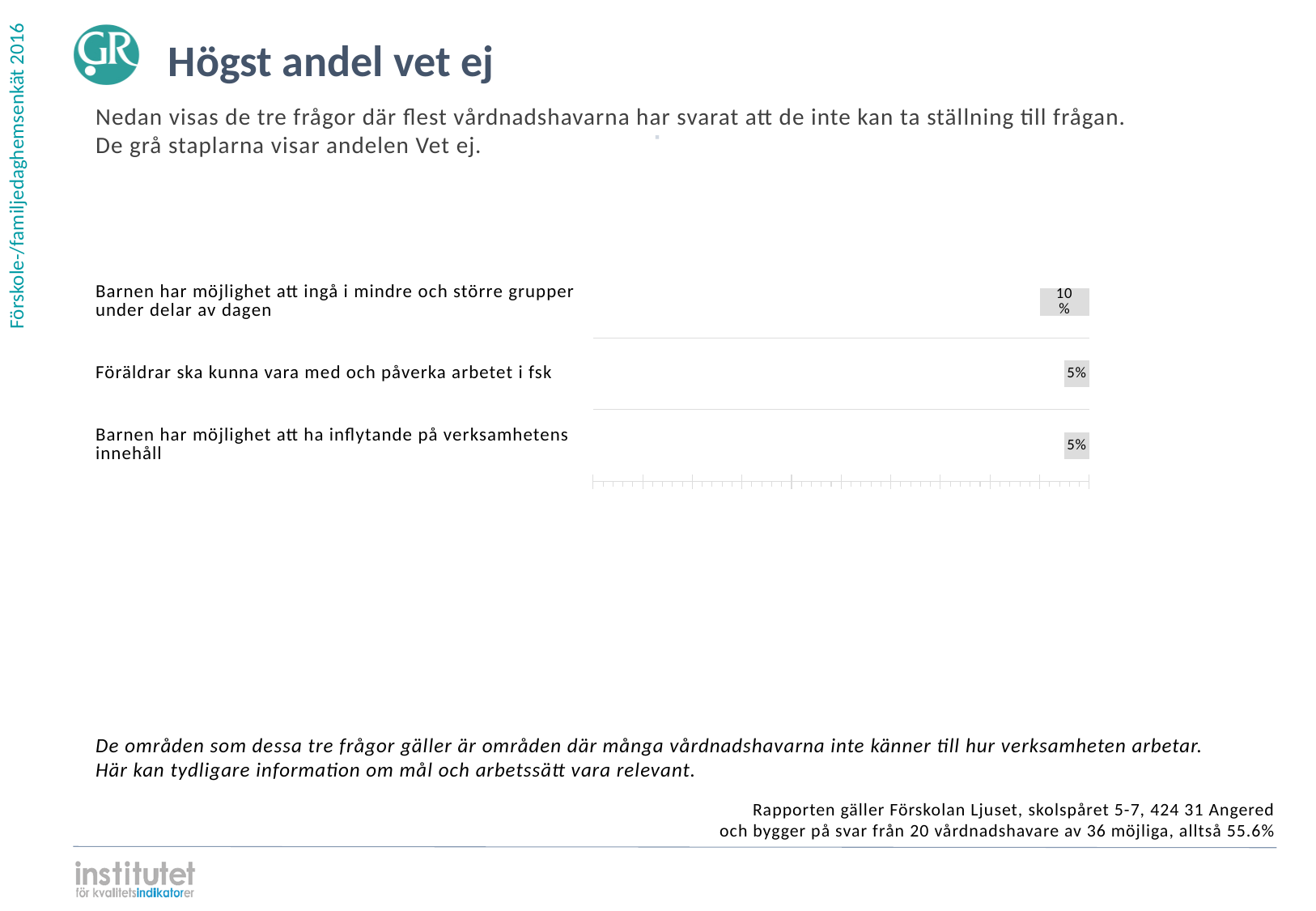
What is the difference in Vet ej share between "Barnen har möjlighet att ingå i mindre och större grupper under delar av dagen" and "Föräldrar ska kunna vara med och påverka arbetet i fsk"? 5% How many of the three questions have a Vet ej share of 5%? 2 What kind of chart is shown on the slide? Bar chart What is the Vet ej share for "Föräldrar ska kunna vara med och påverka arbetet i fsk"? 5% What is the Vet ej share for "Barnen har möjlighet att ingå i mindre och större grupper under delar av dagen"? 10% What is the title of the slide containing the chart? Högst andel vet ej What colour are the bars showing the Vet ej share? Grey Which has a larger Vet ej share: "Barnen har möjlighet att ingå i mindre och större grupper under delar av dagen" or "Barnen har möjlighet att ha inflytande på verksamhetens innehåll"? Barnen har möjlighet att ingå i mindre och större grupper under delar av dagen Which question has the highest Vet ej share? Barnen har möjlighet att ingå i mindre och större grupper under delar av dagen How many questions (categories) are shown in the chart? 3 What is the Vet ej share for "Barnen har möjlighet att ha inflytande på verksamhetens innehåll"? 5%